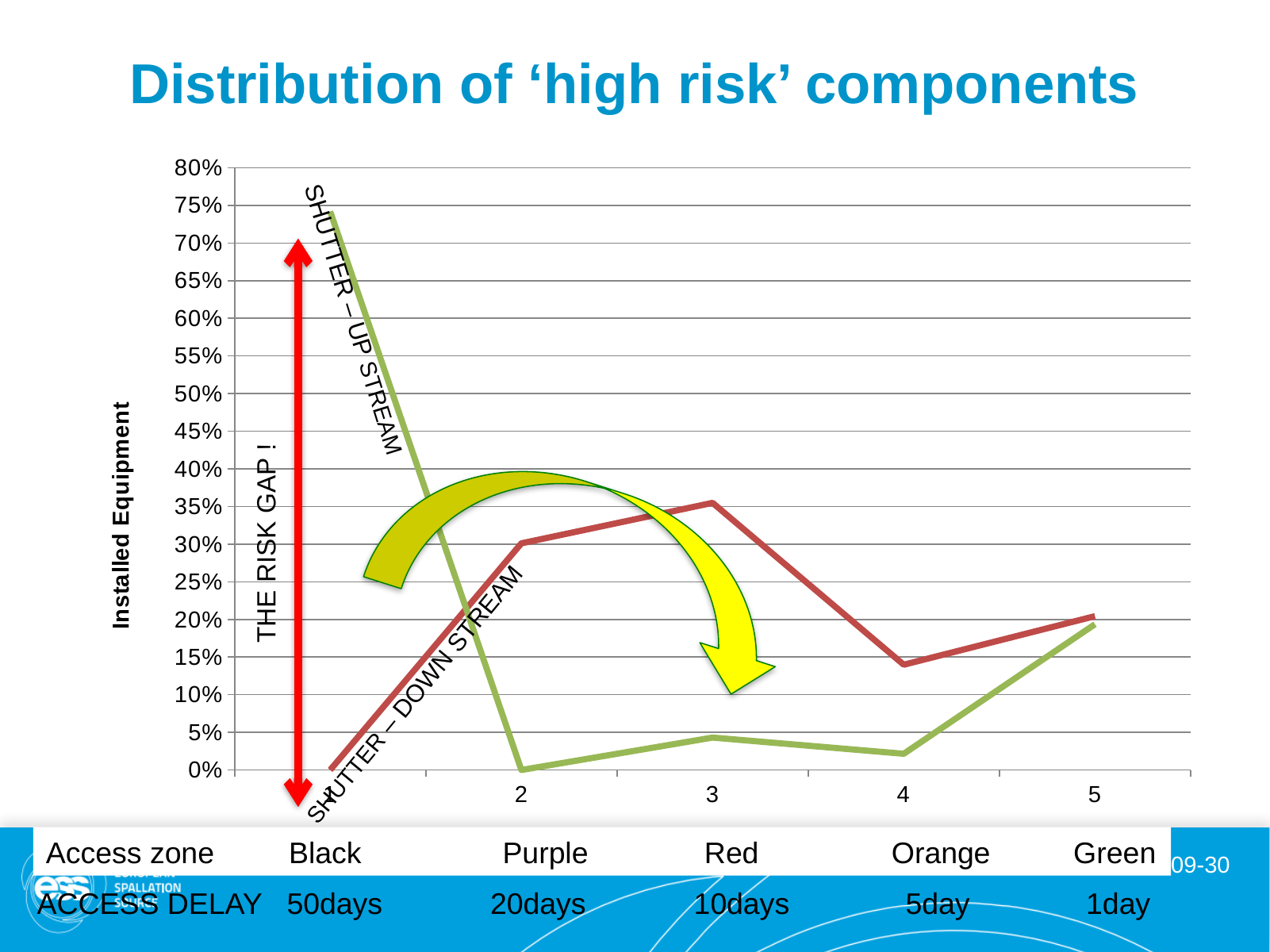
Is the value of the green 'SHUTTER – UP STREAM' line at x = 1 greater or less than 70%? greater Does the green 'SHUTTER – UP STREAM' line rise or fall from x = 1 to x = 2? fall Is the value of the red 'SHUTTER – DOWN STREAM' line at x = 4 greater or less than 20%? less What kind of chart is shown on the slide? line chart How many lines (series) are plotted in the chart? 2 How many x-axis points does each line in the chart have? 5 Is the value of the red 'SHUTTER – DOWN STREAM' line at x = 3 greater or less than 30%? greater What is the title of the vertical axis of the chart? Installed Equipment At x = 3, which line is higher, the green 'SHUTTER – UP STREAM' line or the red 'SHUTTER – DOWN STREAM' line? SHUTTER – DOWN STREAM At which x-axis point does the green 'SHUTTER – UP STREAM' line reach its highest value? 1 At which x-axis point does the red 'SHUTTER – DOWN STREAM' line have its lowest value? 1 What is the value of the green 'SHUTTER – UP STREAM' line at x = 2? 0%